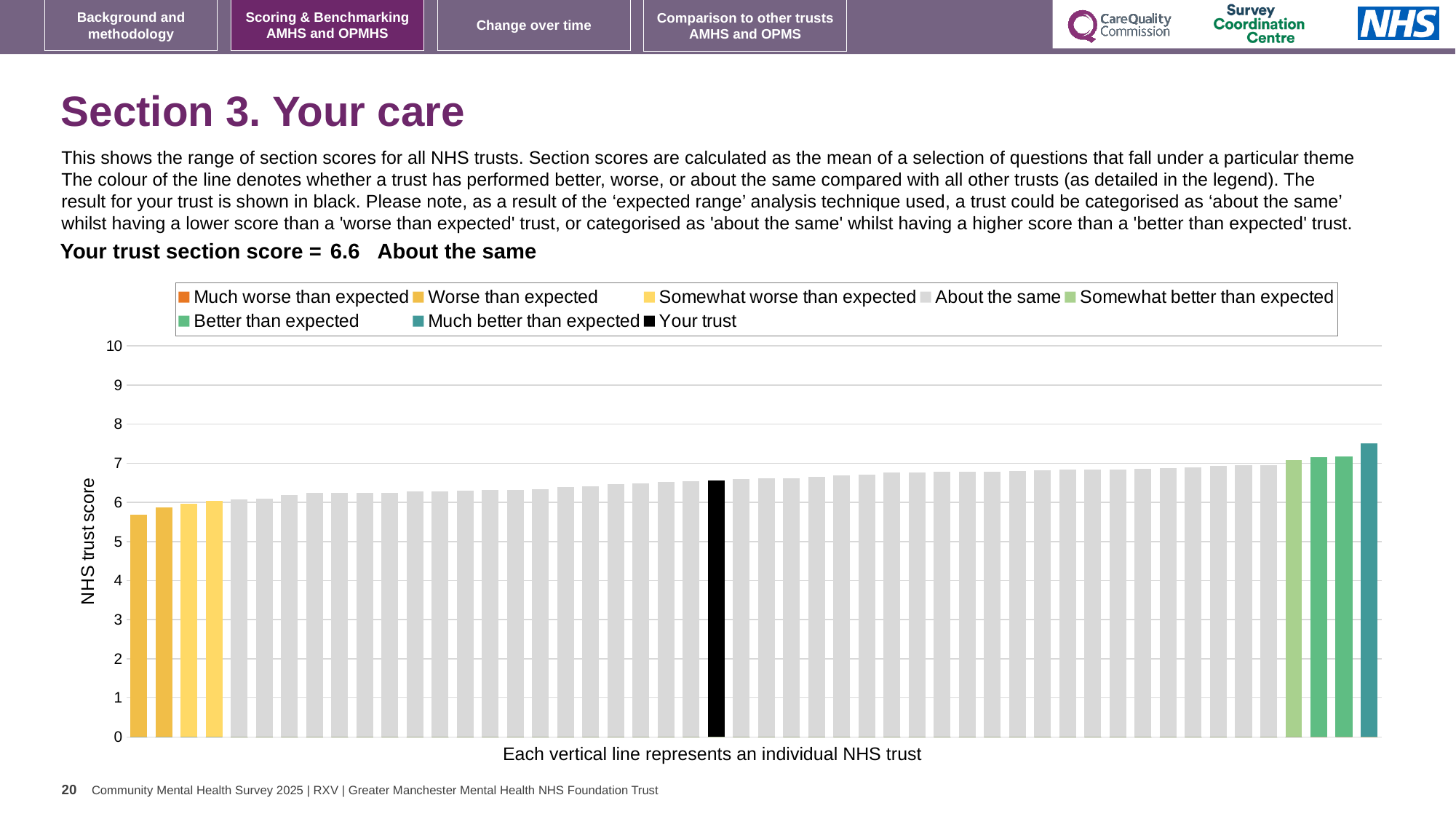
What does the label under the x axis say each vertical line represents? an individual NHS trust What is the title of the vertical axis? NHS trust score Is the value for the leftmost bar greater or less than 6? less How many entries does the chart legend list? 8 What is the section score for your trust shown on the slide? 6.6 Is the value for your trust (the black bar) greater or less than 7? less Do the bar values rise or fall from left to right along the x axis? rise Which is larger, the leftmost bar or the rightmost bar? the rightmost bar Which category is your trust placed in for this section? About the same Is the value for the rightmost bar greater or less than 7? greater Which legend category does the highest bar belong to? Much better than expected What kind of chart is shown on the slide? bar chart